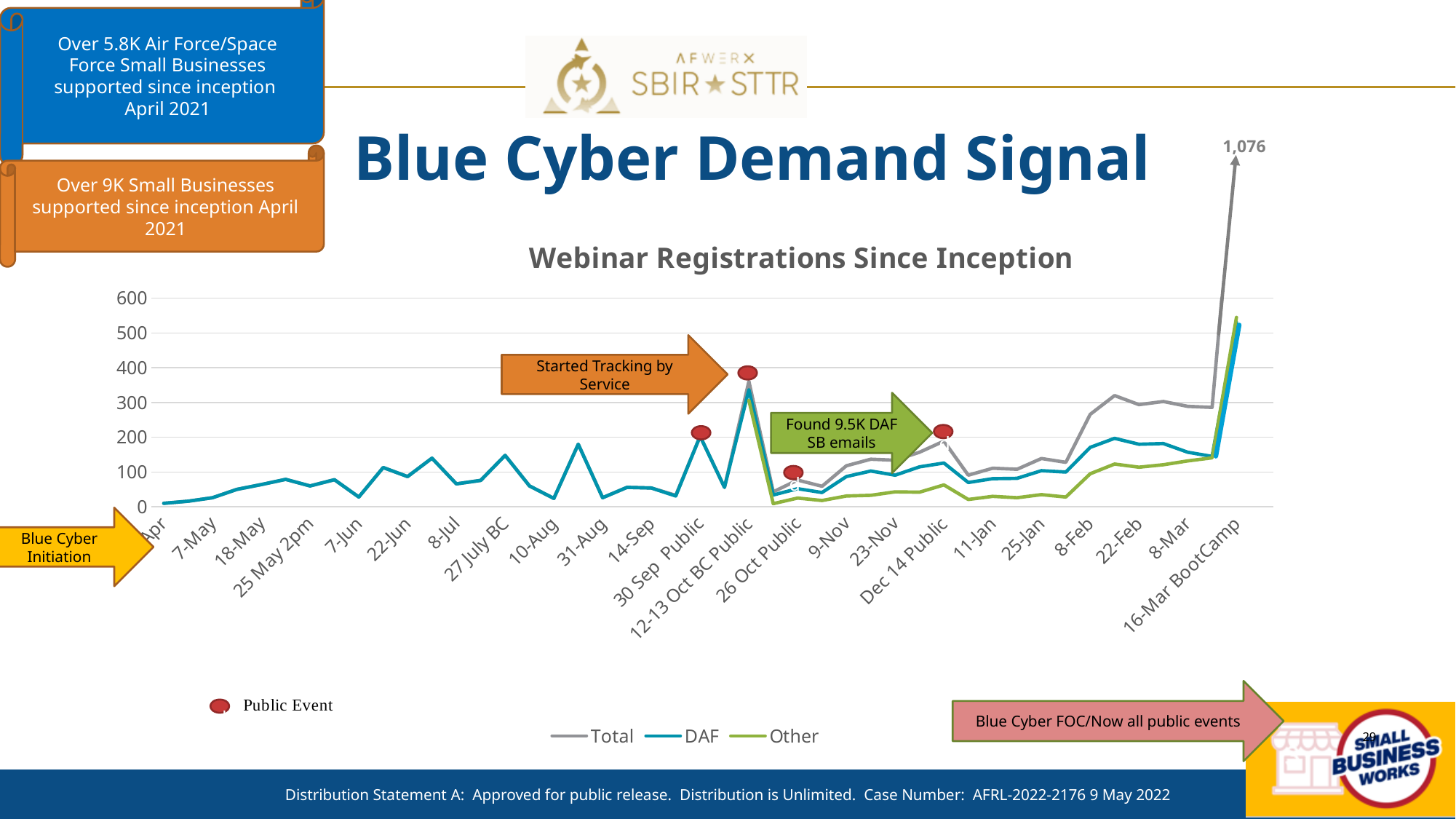
Is the DAF value at 22-Feb greater or less than 100? greater At which x-axis category does the Total series reach its highest value? 16-Mar BootCamp Does the Total series end higher or lower at 16-Mar BootCamp than it starts at Apr? higher What kind of chart is shown on the slide? line chart How many series does the chart legend list? 3 What is the title of the chart? Webinar Registrations Since Inception What is the Total value at 16-Mar BootCamp? 1,076 Is the Other value at 26 Oct Public greater or less than 100? less Is the DAF value at 12-13 Oct BC Public greater or less than 200? greater At 8-Mar, which series has the larger value, Total or Other? Total What are the series names listed in the chart legend? Total, DAF, Other